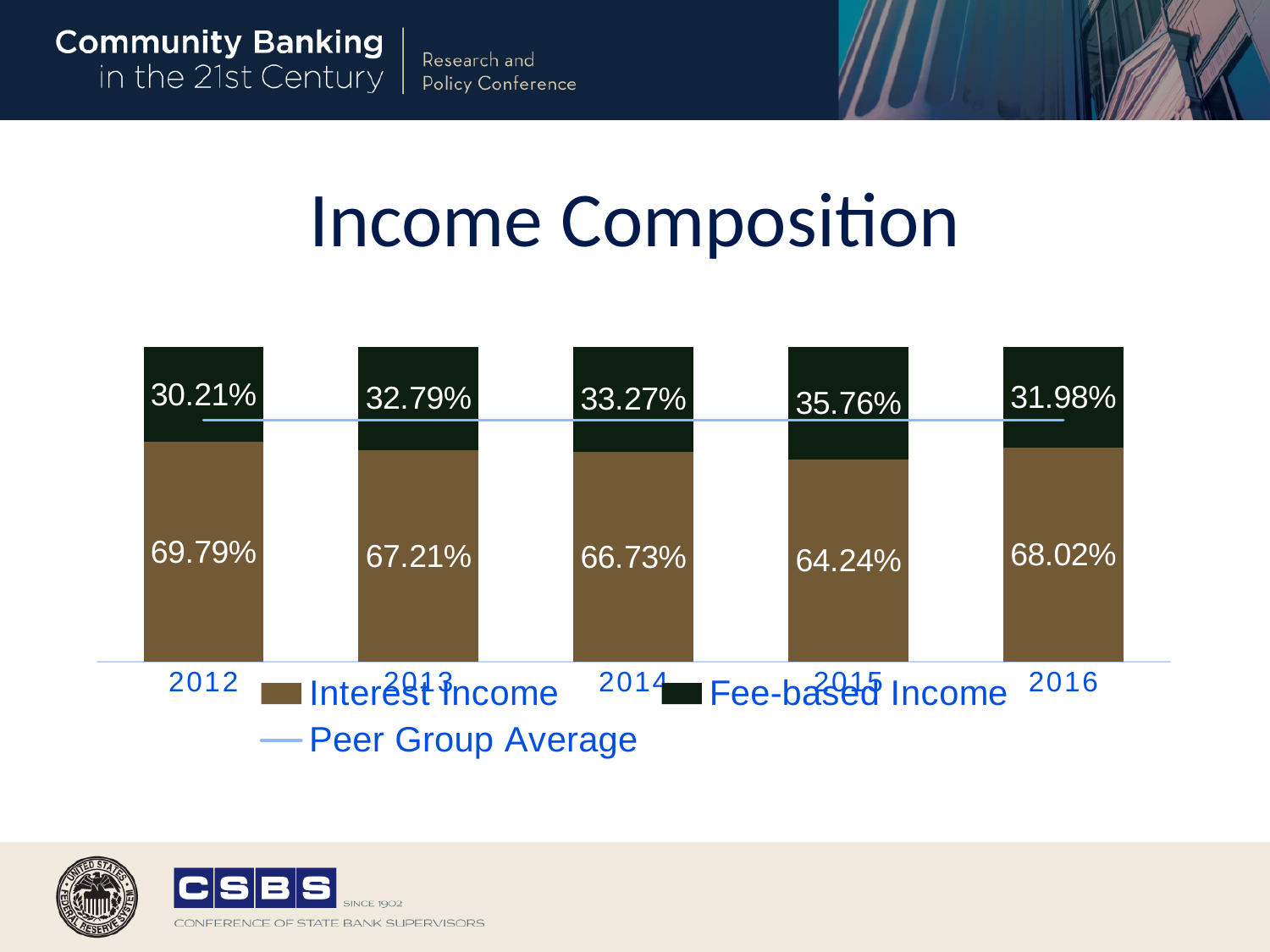
Which year has the lowest Interest Income share? 2015 Which year has the highest Fee-based Income share? 2015 What is the Fee-based Income value for 2016? 31.98% How many years are shown on the x axis? 5 Which year has the highest Interest Income share? 2012 What is the Fee-based Income value for 2015? 35.76% How many entries does the legend list? 3 What is the difference between the Interest Income values for 2012 and 2016? 1.77% Is the Fee-based Income value larger in 2013 or in 2014? 2014 What is the Interest Income value for 2012? 69.79% What kind of chart is shown on the slide? Stacked bar chart What is the title of the chart? Income Composition